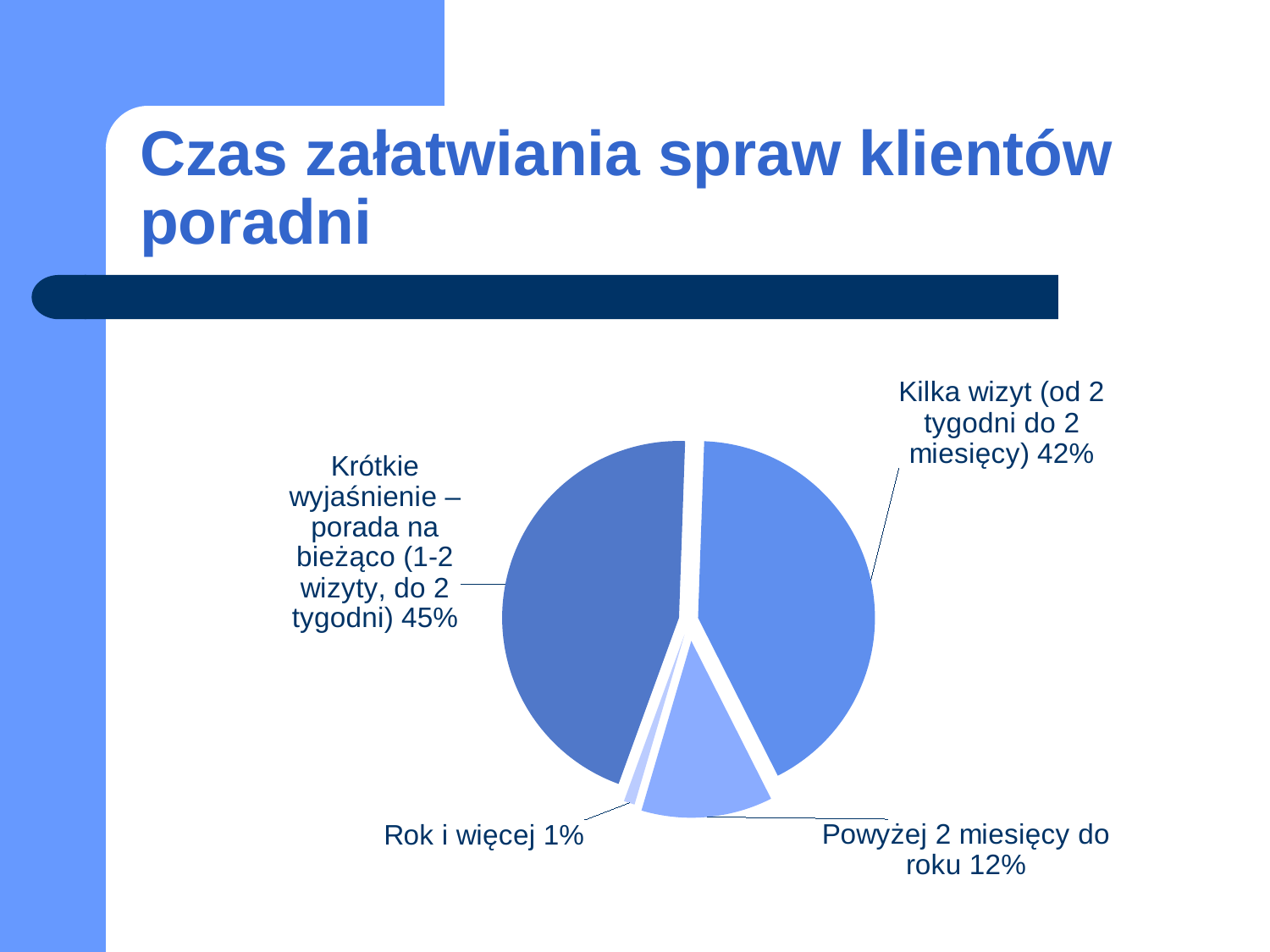
What is the title of the slide? Czas załatwiania spraw klientów poradni What share of the pie is "Kilka wizyt (od 2 tygodni do 2 miesięcy)"? 42% Which category has the smallest share of the pie? Rok i więcej How many slices does the pie chart have? 4 What is the combined share of "Powyżej 2 miesięcy do roku" and "Rok i więcej"? 13% Which is larger: the share for "Powyżej 2 miesięcy do roku" or the share for "Rok i więcej"? Powyżej 2 miesięcy do roku What share of the pie is "Rok i więcej"? 1% Which category has the largest share of the pie? Krótkie wyjaśnienie – porada na bieżąco (1-2 wizyty, do 2 tygodni) What share of the pie is "Krótkie wyjaśnienie – porada na bieżąco (1-2 wizyty, do 2 tygodni)"? 45% What share of the pie is "Powyżej 2 miesięcy do roku"? 12% What kind of chart is shown on the slide? Pie chart What is the difference in percentage points between "Krótkie wyjaśnienie – porada na bieżąco" and "Kilka wizyt (od 2 tygodni do 2 miesięcy)"? 3 percentage points